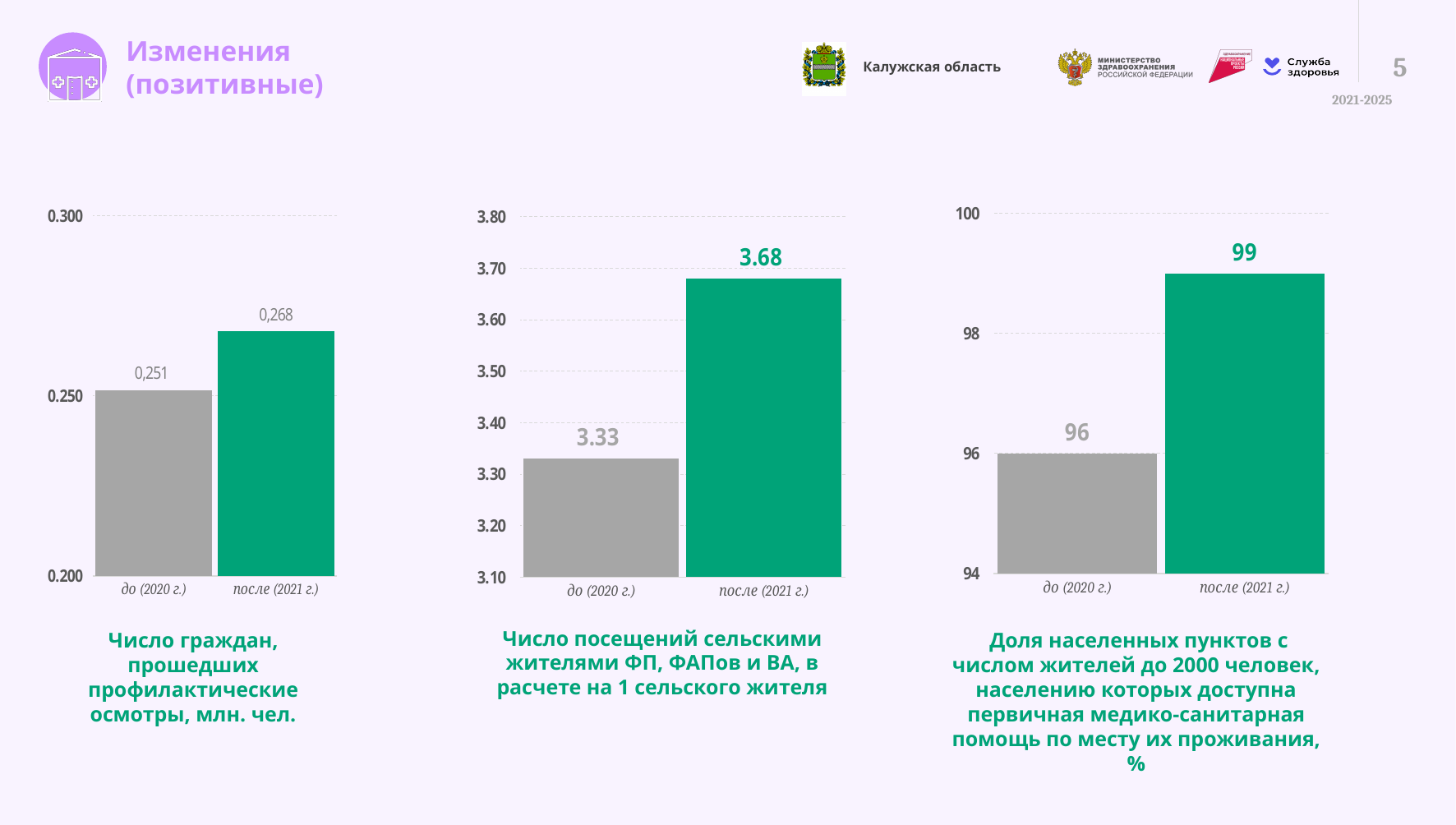
In the left chart (Число граждан, прошедших профилактические осмотры, млн. чел.), what is the value for 'после (2021 г.)'? 0,268 In the middle chart (Число посещений сельскими жителями ФП, ФАПов и ВА), which category has the higher value? после (2021 г.) In the left chart (Число граждан, прошедших профилактические осмотры, млн. чел.), what is the difference between the 'после (2021 г.)' and 'до (2020 г.)' values? 0,017 In the middle chart (Число посещений сельскими жителями ФП, ФАПов и ВА), by how much does the 'после (2021 г.)' value exceed the 'до (2020 г.)' value? 0.35 In the right chart (Доля населенных пунктов ... %), what is the difference between the 'после (2021 г.)' and 'до (2020 г.)' values? 3 What kind of chart is the left chart (Число граждан, прошедших профилактические осмотры, млн. чел.)? bar chart In the middle chart (Число посещений сельскими жителями ФП, ФАПов и ВА), what is the value for 'после (2021 г.)'? 3.68 How many categories are shown in the right chart (Доля населенных пунктов ... %)? 2 In the left chart (Число граждан, прошедших профилактические осмотры, млн. чел.), what is the value for 'до (2020 г.)'? 0,251 In the middle chart (Число посещений сельскими жителями ФП, ФАПов и ВА), what is the value for 'до (2020 г.)'? 3.33 In the right chart (Доля населенных пунктов ... %), what is the value for 'до (2020 г.)'? 96 In the right chart (Доля населенных пунктов ... %), what is the value for 'после (2021 г.)'? 99